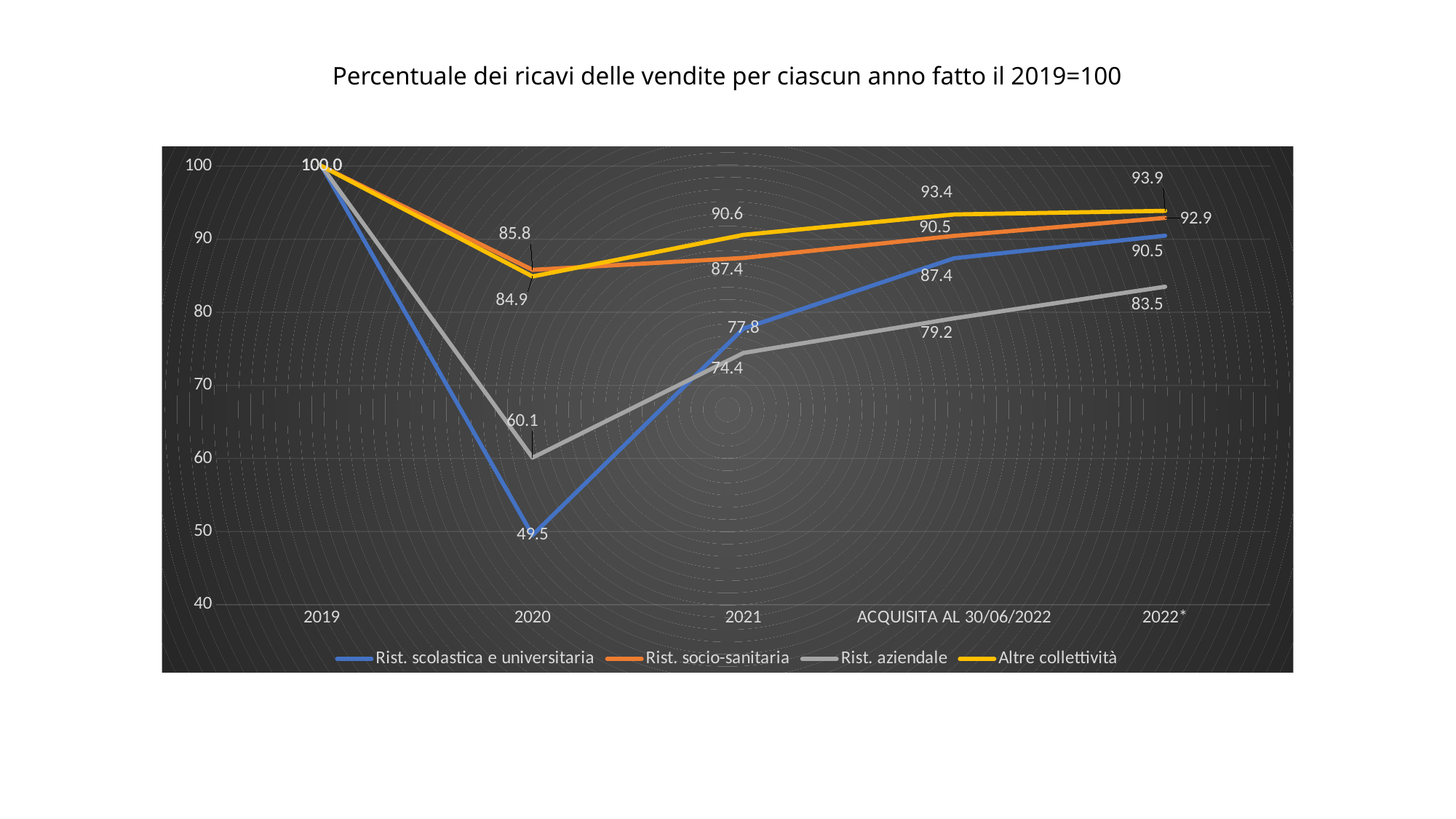
What is the title of the chart? Percentuale dei ricavi delle vendite per ciascun anno fatto il 2019=100 Which series has the highest value in 2022*? Altre collettività How many series does the legend list? 4 What kind of chart is shown on the slide? line chart By how much did Rist. scolastica e universitaria increase from 2020 to 2021? 28.3 What is the value for Rist. aziendale in 2022*? 83.5 How many points are plotted along the x axis for each series? 5 Does the Rist. aziendale line rise or fall from 2020 to 2022*? rises What is the value for Altre collettività at ACQUISITA AL 30/06/2022? 93.4 What is the value for Rist. scolastica e universitaria in 2020? 49.5 Which series has the lowest value in 2020? Rist. scolastica e universitaria In 2021, which is larger: Rist. scolastica e universitaria or Rist. aziendale? Rist. scolastica e universitaria